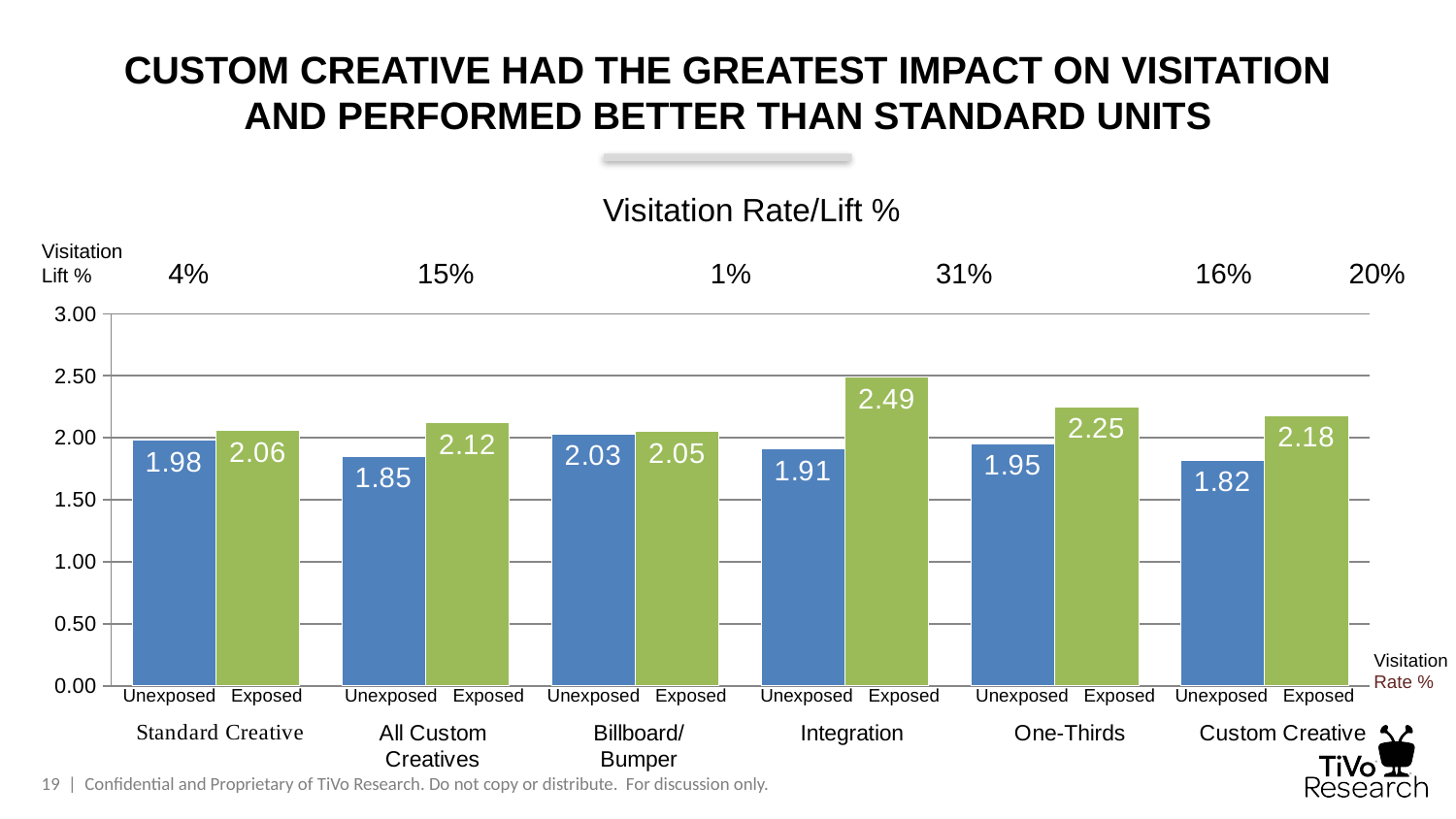
Which is larger, the Exposed visitation rate for Custom Creative or the Exposed visitation rate for All Custom Creatives? Custom Creative What is the Visitation Lift % shown for All Custom Creatives? 15% How many creative categories are shown on the chart? 6 Is the Exposed visitation rate for Integration greater or less than 2.00? greater Which category has the lowest Unexposed visitation rate? Custom Creative What kind of chart is shown on the slide? bar chart What is the difference between the Exposed and Unexposed visitation rates for One-Thirds? 0.30 Which category has the highest Exposed visitation rate? Integration Which category has the lowest Visitation Lift %? Billboard/Bumper What is the Unexposed visitation rate for Custom Creative? 1.82 What is the Exposed visitation rate for Integration? 2.49 What is the title of the chart? Visitation Rate/Lift %